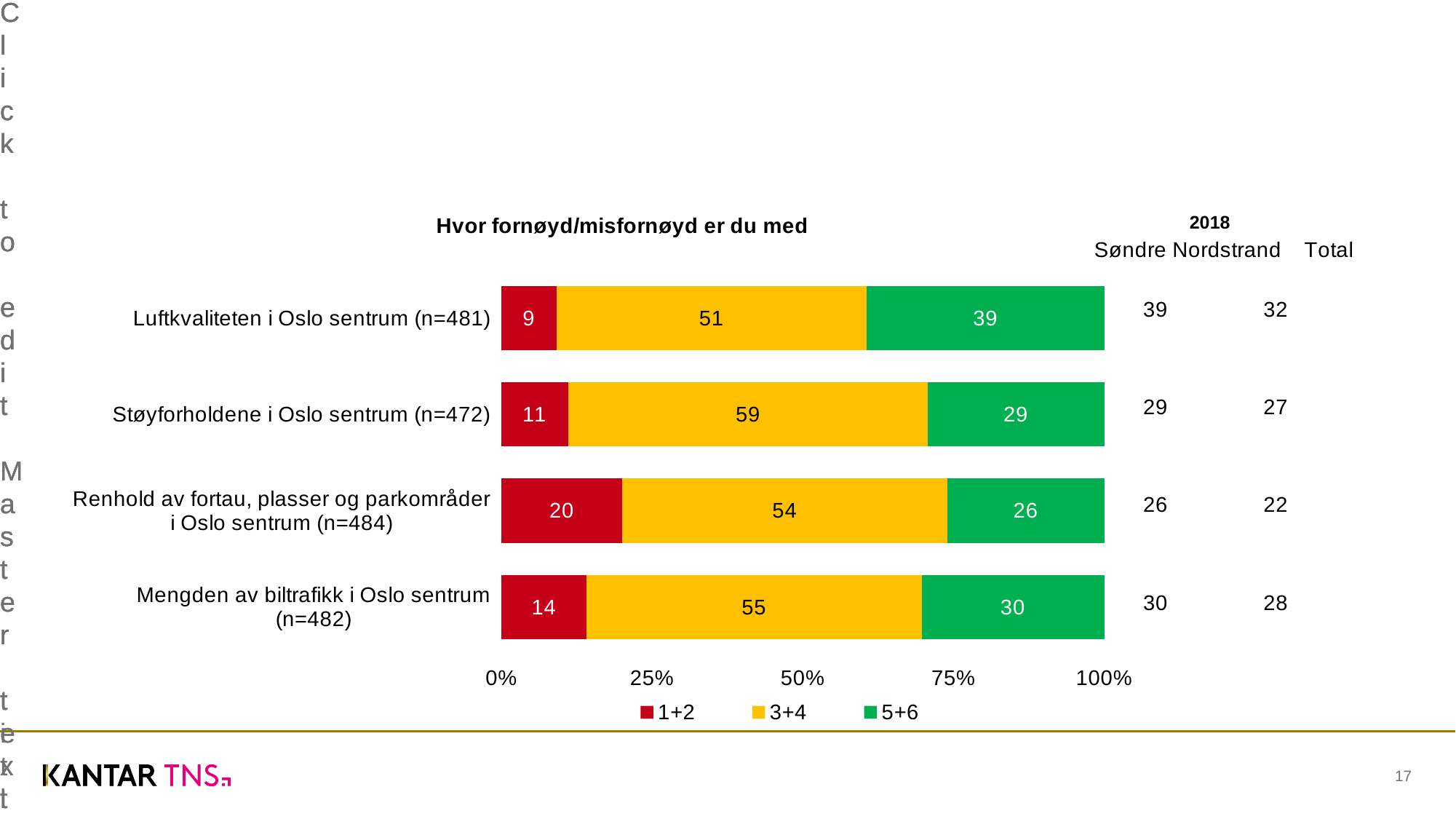
Which category has the highest 1+2 value? Renhold av fortau, plasser og parkområder i Oslo sentrum (n=484) What is the total of the stacked bar for Renhold av fortau, plasser og parkområder i Oslo sentrum (n=484)? 100 What is the value of the 3+4 segment for Støyforholdene i Oslo sentrum (n=472)? 59 Which category has the lowest 5+6 value? Renhold av fortau, plasser og parkområder i Oslo sentrum (n=484) What is the title of the chart? Hvor fornøyd/misfornøyd er du med Which is larger: the 3+4 value for Støyforholdene i Oslo sentrum (n=472) or the 3+4 value for Luftkvaliteten i Oslo sentrum (n=481)? Støyforholdene i Oslo sentrum (n=472) How many series does the legend list? 3 What kind of chart is shown on the slide? Stacked bar chart How many categories are shown in the chart? 4 What is the value of the 1+2 segment for Luftkvaliteten i Oslo sentrum (n=481)? 9 What is the difference between the 5+6 values for Luftkvaliteten i Oslo sentrum (n=481) and Støyforholdene i Oslo sentrum (n=472)? 10 What is the value of the 5+6 segment for Mengden av biltrafikk i Oslo sentrum (n=482)? 30